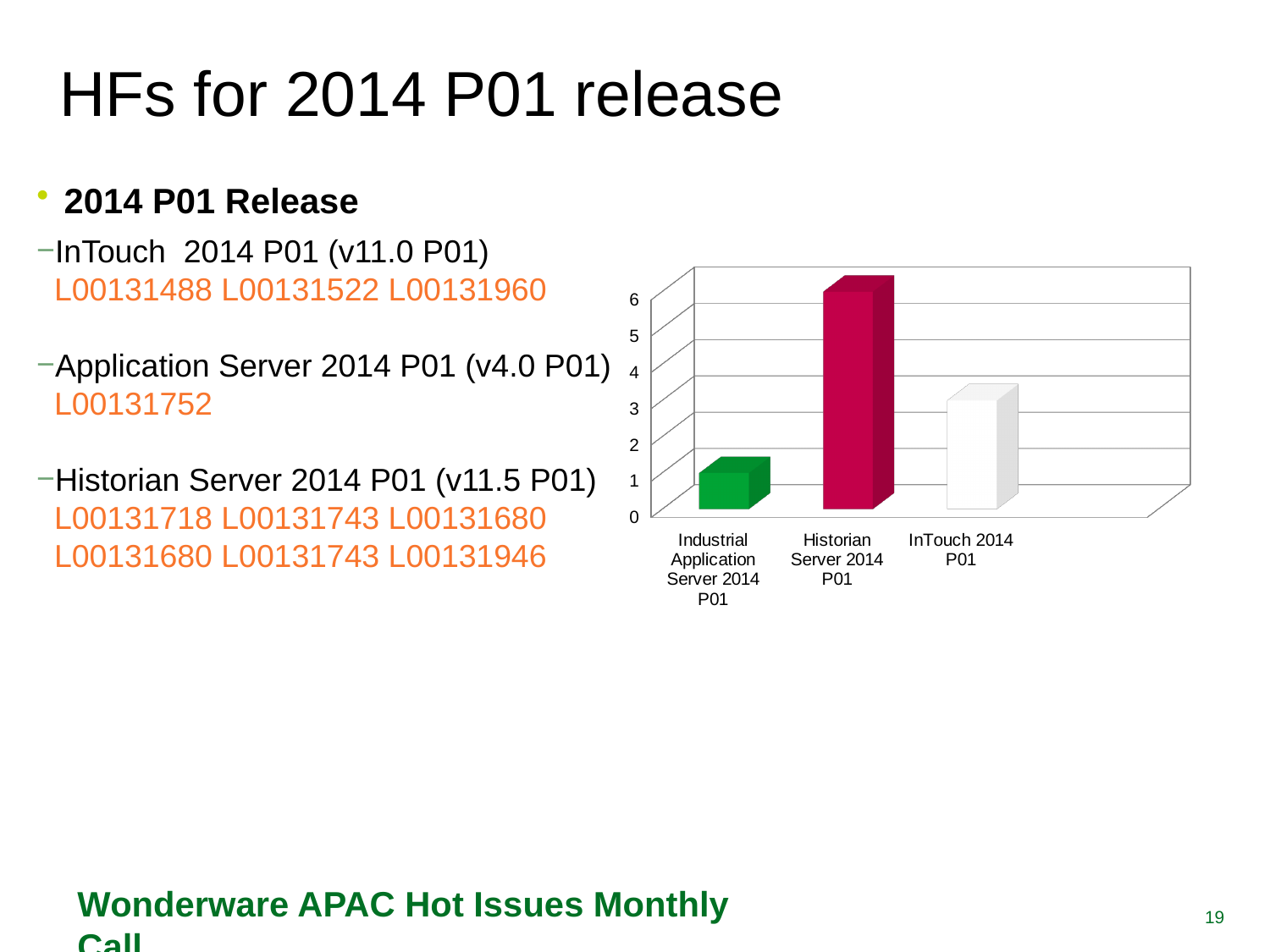
What colour is the bar for Industrial Application Server 2014 P01? green Which category has the highest bar in the chart? Historian Server 2014 P01 Is the value for Historian Server 2014 P01 greater or less than 5? greater Which is larger, the value for Historian Server 2014 P01 or the value for InTouch 2014 P01? Historian Server 2014 P01 Which is larger, the value for InTouch 2014 P01 or the value for Industrial Application Server 2014 P01? InTouch 2014 P01 Is the value for Industrial Application Server 2014 P01 greater or less than 2? less How many categories are plotted in the chart? 3 Is the value for InTouch 2014 P01 greater or less than 4? less Which category has the lowest bar in the chart? Industrial Application Server 2014 P01 What kind of chart is shown on the slide? bar chart What colour is the bar for Historian Server 2014 P01? red